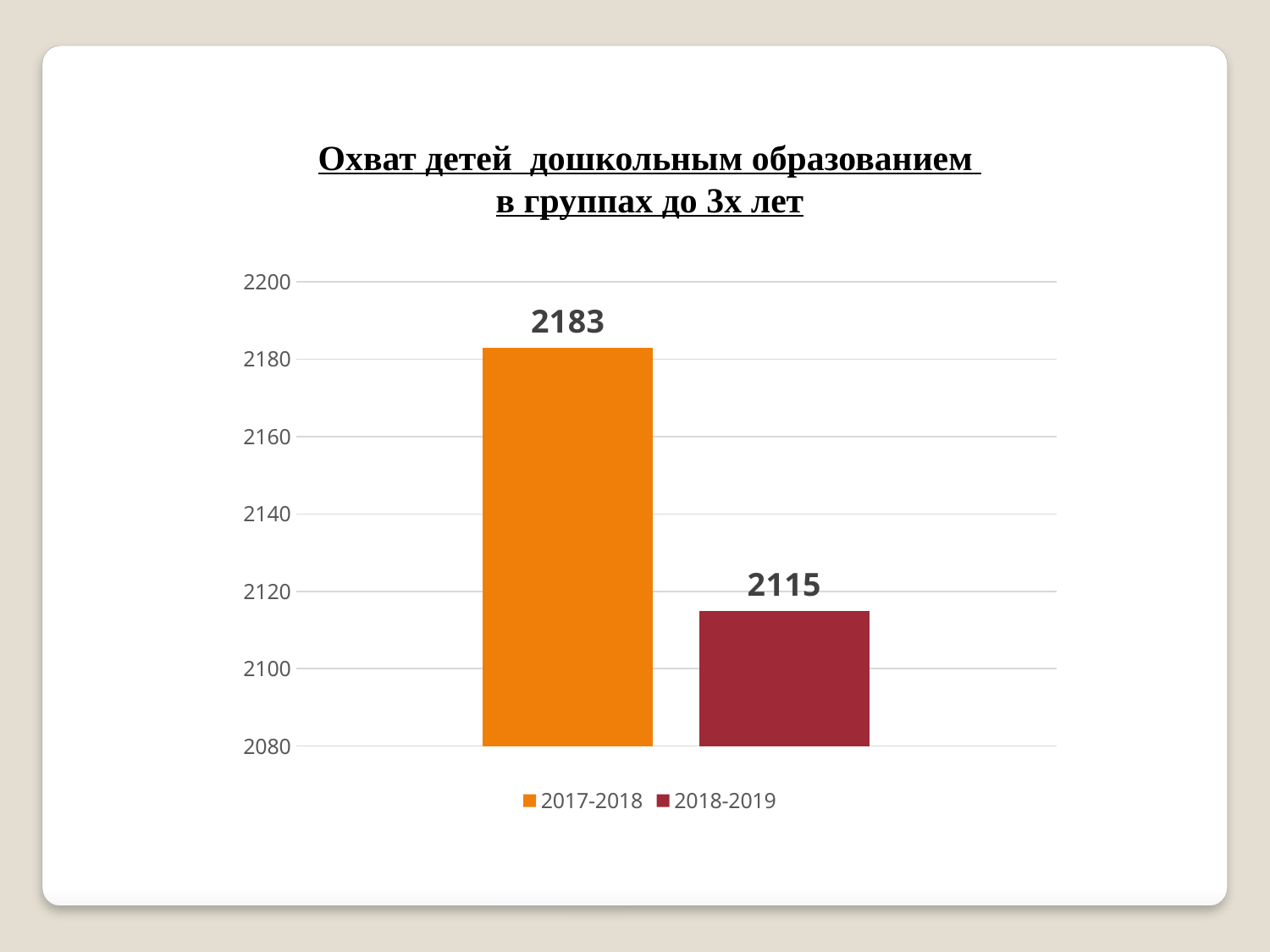
How many bars are shown in the chart? 2 What colour is the bar for 2018-2019? dark red Which period has the higher value? 2017-2018 What is the value for 2018-2019? 2115 Is the value for 2017-2018 greater or less than 2160? greater What is the value for 2017-2018? 2183 Do the values rise or fall from 2017-2018 to 2018-2019? fall Which period has the lower value? 2018-2019 How many series does the legend list? 2 What is the difference between the values for 2017-2018 and 2018-2019? 68 What kind of chart is shown on the slide? bar chart Is the value for 2018-2019 greater or less than 2140? less